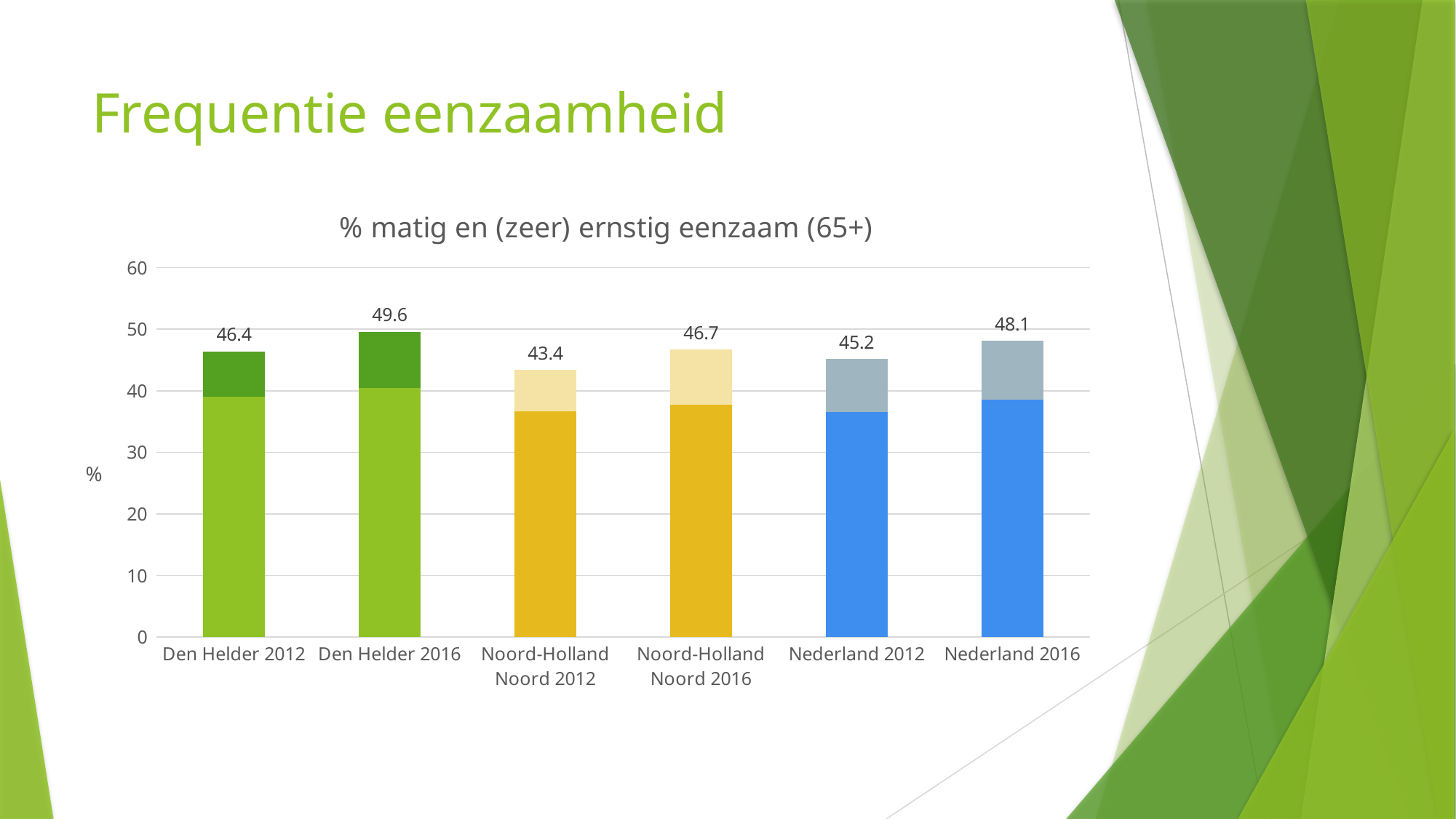
What is the difference between the totals for Den Helder 2016 and Den Helder 2012? 3.2 What is the difference between the totals for Nederland 2016 and Nederland 2012? 2.9 How many categories are shown on the x axis? 6 What is the total value shown for Noord-Holland Noord 2012? 43.4 Which category has the lowest total value? Noord-Holland Noord 2012 Which has a larger total, Noord-Holland Noord 2016 or Nederland 2012? Noord-Holland Noord 2016 What is the total value shown for Nederland 2016? 48.1 Is the lower (dark blue) segment of the Nederland 2012 bar greater or less than 40? less What is the total value shown for Den Helder 2016? 49.6 Which category has the highest total value? Den Helder 2016 What kind of chart is shown on the slide? Stacked bar chart What is the title of the chart? % matig en (zeer) ernstig eenzaam (65+)